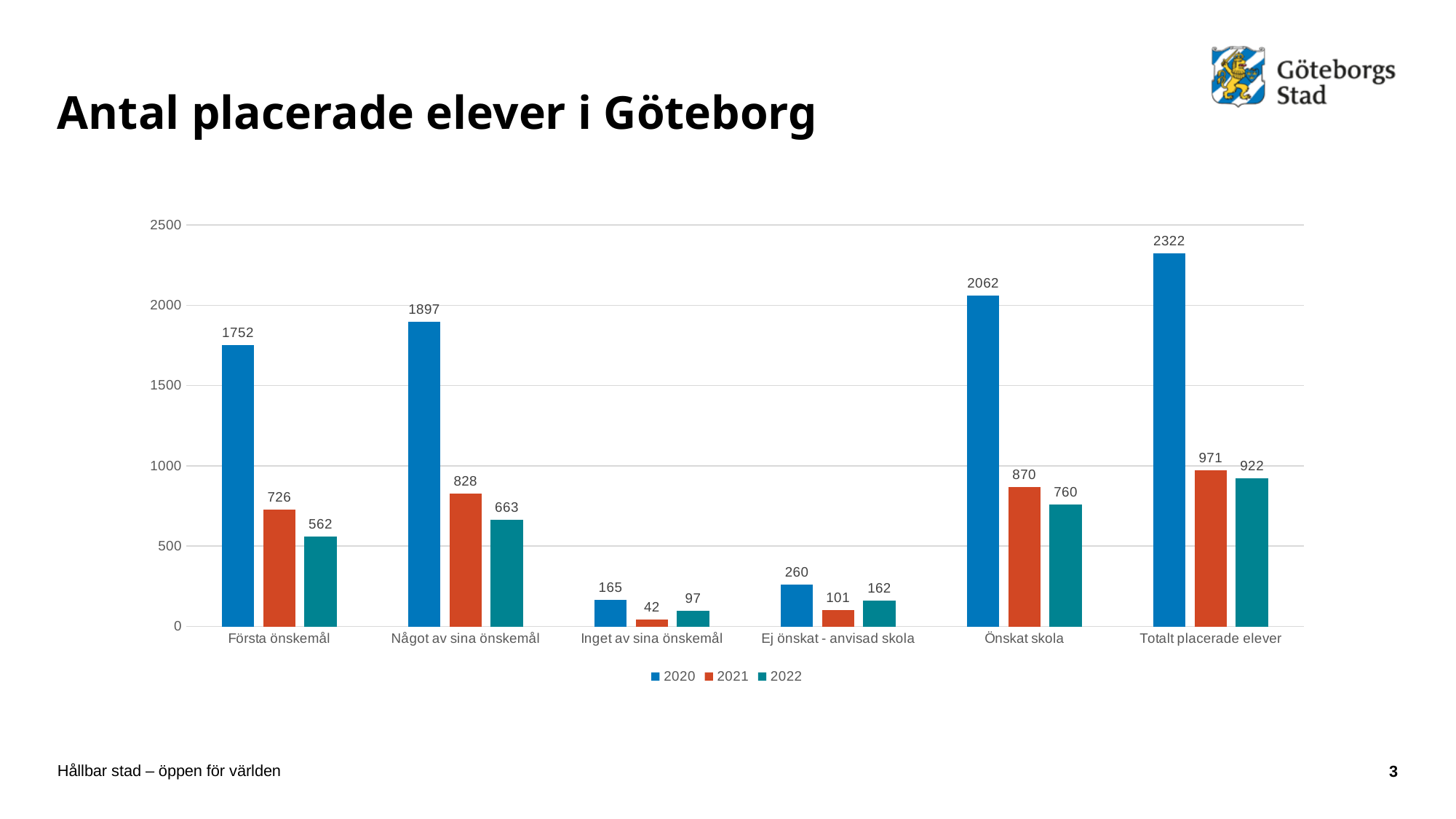
What is the difference between the 2021 and 2022 values for Totalt placerade elever? 49 How many categories are shown on the x axis? 6 Which category has the highest value for the 2020 series? Totalt placerade elever What is the value for 2021 in the Inget av sina önskemål category? 42 Which is larger in the Ej önskat - anvisad skola category: the 2021 value or the 2022 value? 2022 What is the value for 2020 in the Första önskemål category? 1752 Which category has the lowest value for the 2022 series? Inget av sina önskemål Is the 2020 value for Önskat skola greater or less than 2000? greater How many series does the legend list? 3 What is the title of the chart on the slide? Antal placerade elever i Göteborg What kind of chart is shown on the slide? Bar chart What is the value for 2022 in the Önskat skola category? 760